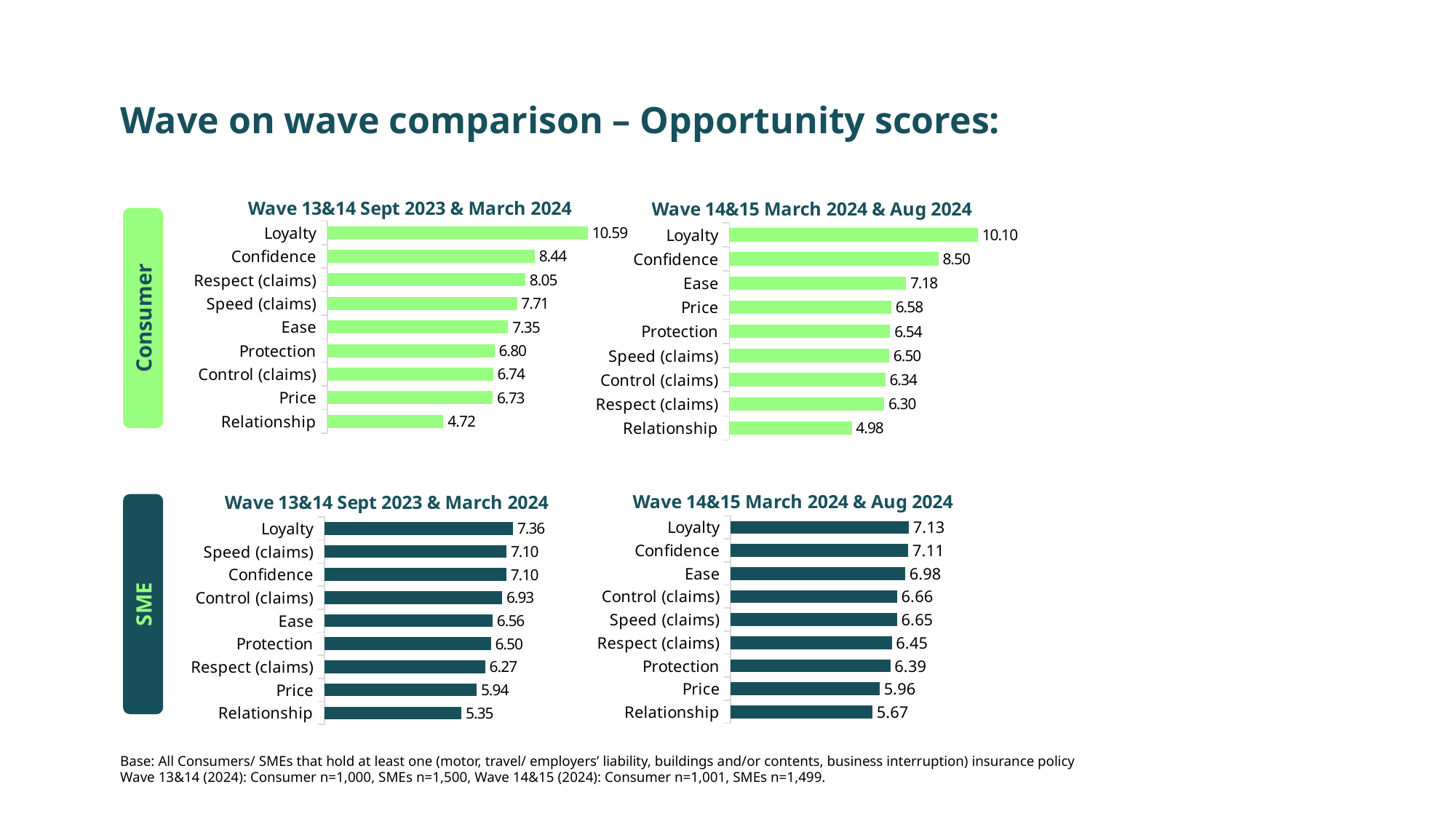
In the SME Wave 13&14 Sept 2023 & March 2024 chart (bottom left), what is the value for Price? 5.94 In the Consumer Wave 14&15 March 2024 & Aug 2024 chart (top right), what is the value for Ease? 7.18 In the Consumer Wave 13&14 Sept 2023 & March 2024 chart (top left), what is the difference between Loyalty and Relationship? 5.87 In the Consumer Wave 14&15 March 2024 & Aug 2024 chart (top right), which category has the highest value? Loyalty What colour are the bars in the SME charts on the bottom row? Dark teal What kind of chart is the Consumer Wave 13&14 Sept 2023 & March 2024 chart (top left)? Bar chart How many categories are shown in the SME Wave 13&14 Sept 2023 & March 2024 chart (bottom left)? 9 In the Consumer Wave 14&15 March 2024 & Aug 2024 chart (top right), which is larger, Price or Relationship? Price In the SME Wave 14&15 March 2024 & Aug 2024 chart (bottom right), which category has the lowest value? Relationship In the Consumer Wave 13&14 Sept 2023 & March 2024 chart (top left), what is the value for Loyalty? 10.59 In the SME Wave 13&14 Sept 2023 & March 2024 chart (bottom left), which is larger, Ease or Respect (claims)? Ease In the SME Wave 14&15 March 2024 & Aug 2024 chart (bottom right), what is the difference between Loyalty and Confidence? 0.02